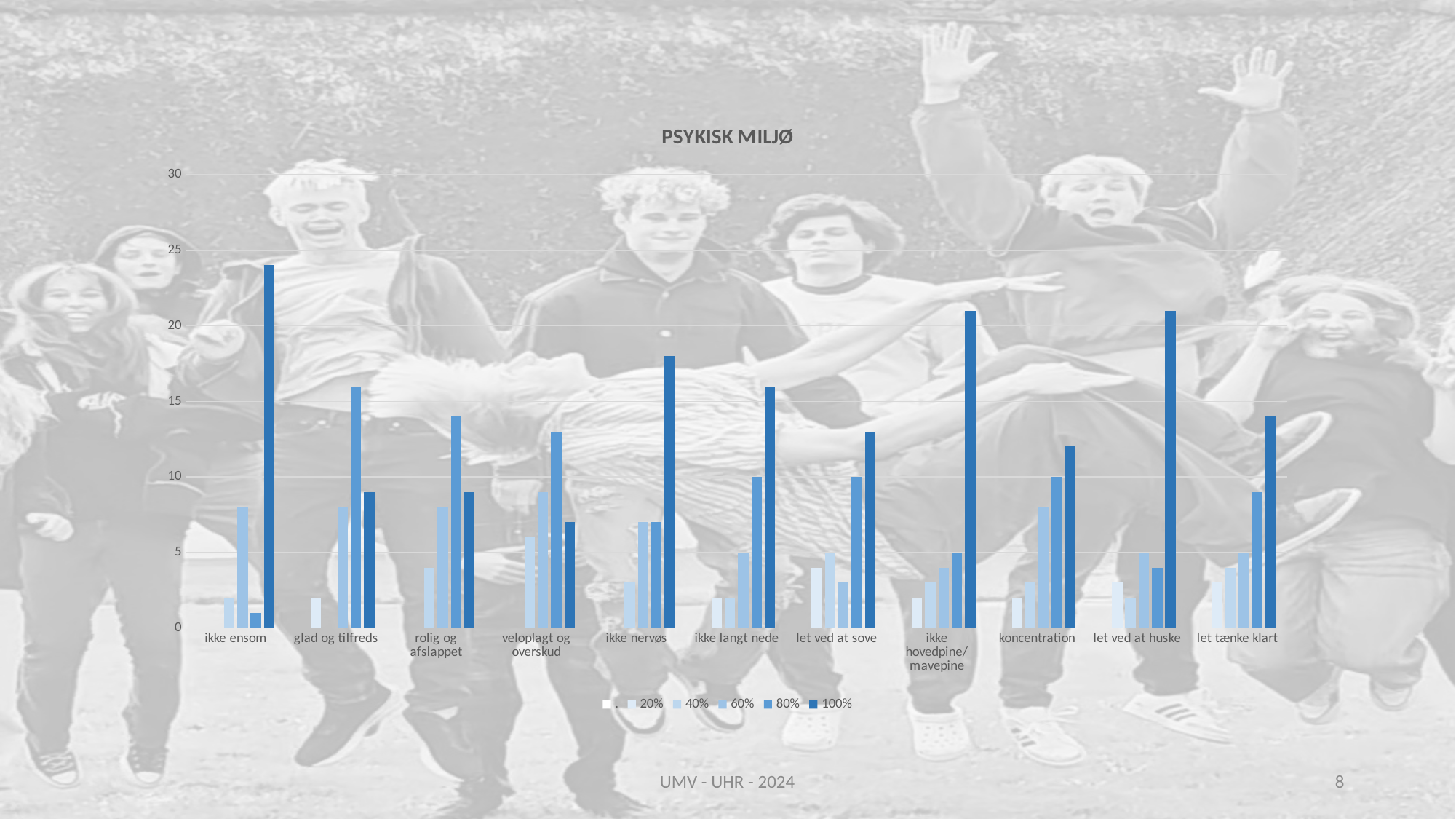
Which is larger: the 100% value for ikke hovedpine/mavepine or the 100% value for koncentration? ikke hovedpine/mavepine Which category has the tallest 100% bar? ikke ensom How many series does the chart's legend list? 6 How many categories are shown along the x axis of the chart? 11 Is the 100% value for veloplagt og overskud greater or less than 10? less Which category has the shortest 100% bar? veloplagt og overskud What is the title of the chart? PSYKISK MILJØ Which is larger: the 100% value for ikke ensom or the 100% value for glad og tilfreds? ikke ensom What kind of chart is shown on the slide? bar chart Is the 80% value for ikke nervøs greater or less than 10? less Is the 100% value for ikke ensom greater or less than 20? greater